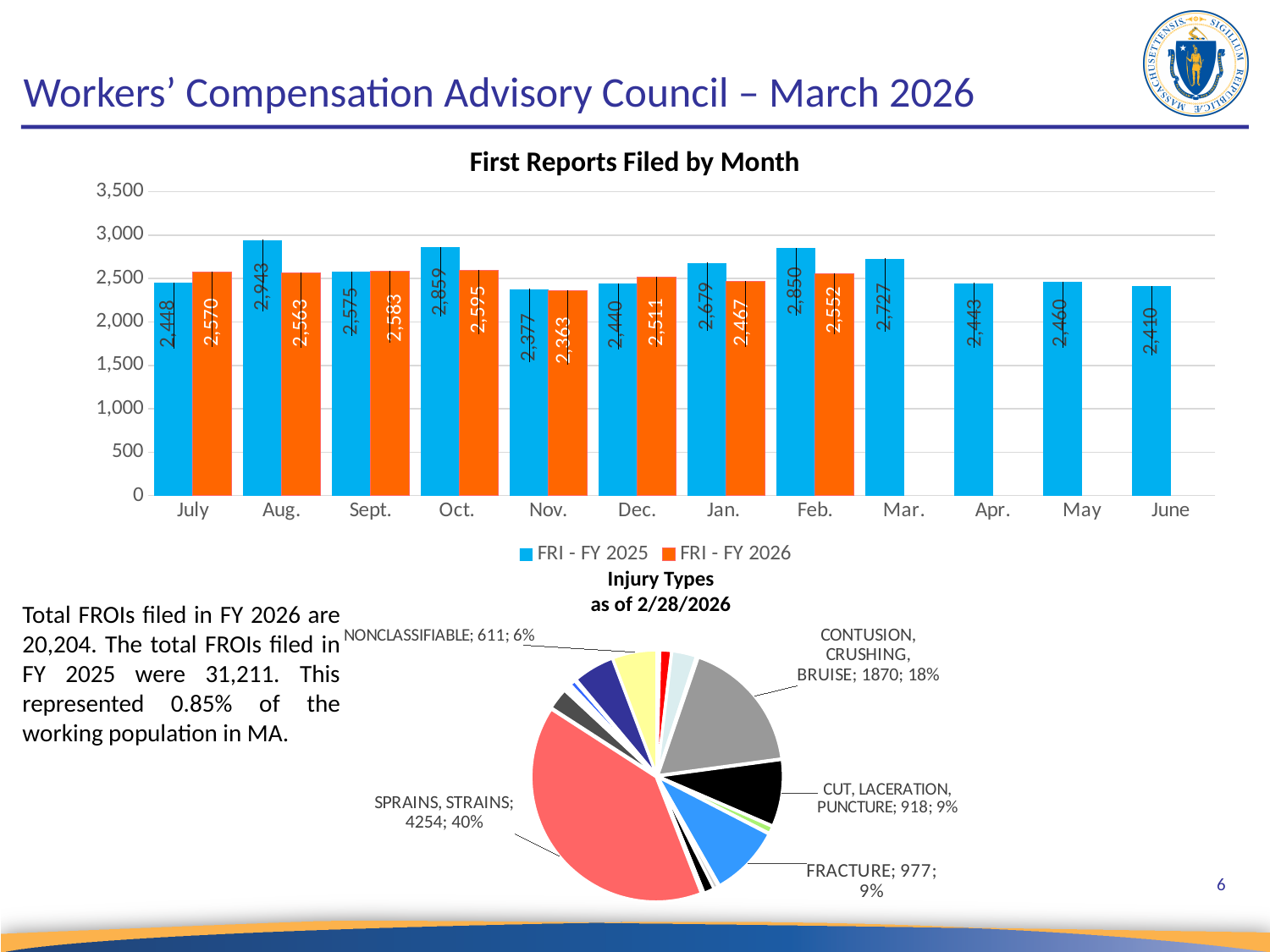
In the 'First Reports Filed by Month' chart, what is the difference between the FRI - FY 2025 and FRI - FY 2026 values for August? 380 In the 'First Reports Filed by Month' chart, what is the FRI - FY 2026 value for October? 2,595 In the 'Injury Types as of 2/28/2026' pie chart, what is the value for CONTUSION, CRUSHING, BRUISE? 1870 In the 'First Reports Filed by Month' chart, how many months have an FRI - FY 2026 bar? 8 In the 'First Reports Filed by Month' chart, which is larger for December: FRI - FY 2025 or FRI - FY 2026? FRI - FY 2026 In the 'First Reports Filed by Month' chart, which month has the highest FRI - FY 2025 value? Aug. In the 'First Reports Filed by Month' chart, how many series does the legend list? 2 In the 'Injury Types as of 2/28/2026' pie chart, what share does SPRAINS, STRAINS represent? 40% In the 'Injury Types as of 2/28/2026' pie chart, what is the difference between the FRACTURE and CUT, LACERATION, PUNCTURE values? 59 What kind of chart is 'First Reports Filed by Month'? Bar chart In the 'First Reports Filed by Month' chart, which month has the lowest FRI - FY 2026 value? Nov. In the 'First Reports Filed by Month' chart, what is the FRI - FY 2025 value for March? 2,727